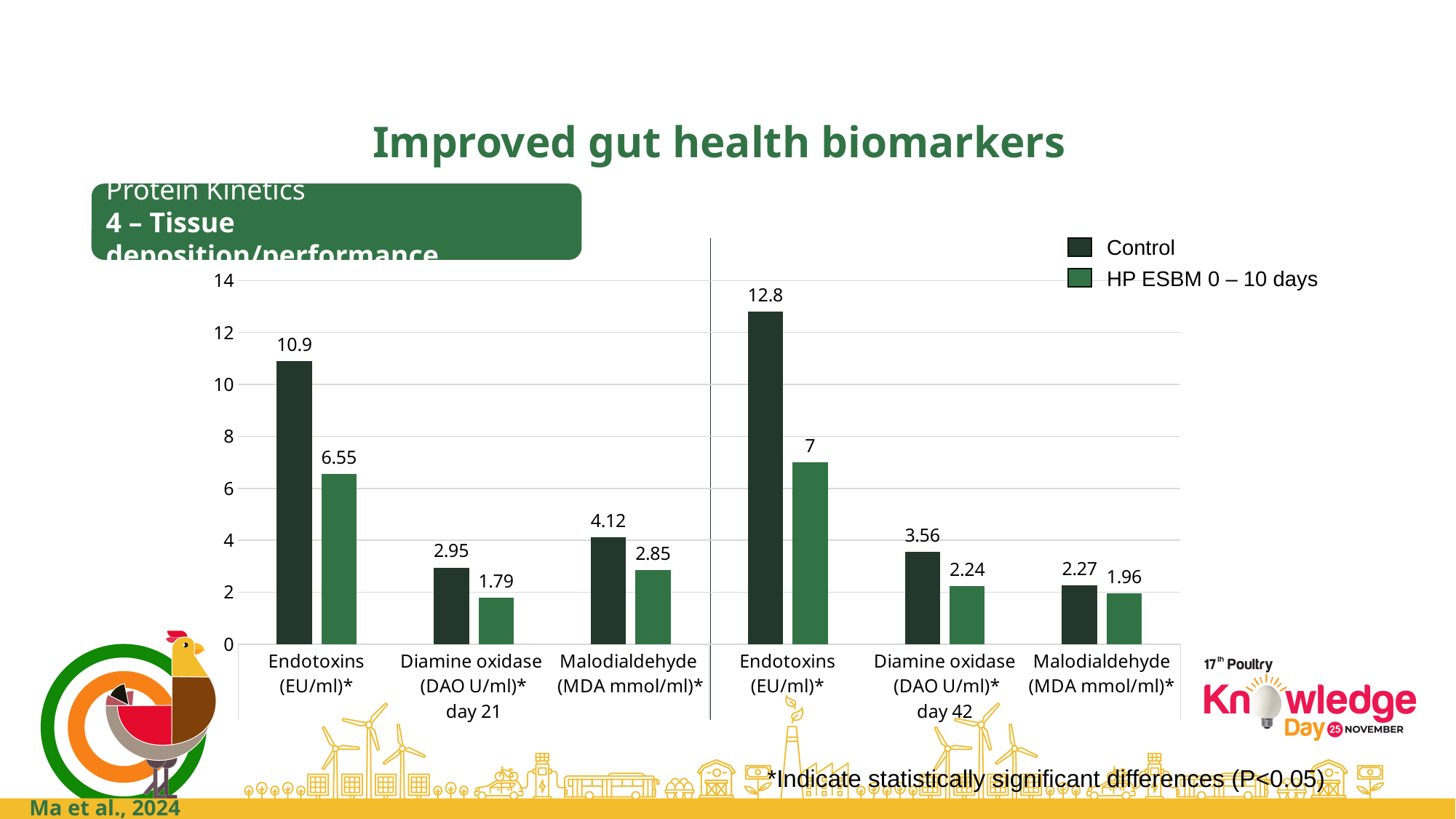
What is the difference between the Control and HP ESBM 0 – 10 days values for Endotoxins (EU/ml) at day 42? 5.8 What is the HP ESBM 0 – 10 days value for Endotoxins (EU/ml) at day 42? 7 What is the Control value for Endotoxins (EU/ml) at day 21? 10.9 Which category has the highest Control value across both days? Endotoxins (EU/ml) day 42 How many series does the legend list? 2 What colour represents the Control series in the legend? Dark green Which is larger: the Control value for Diamine oxidase at day 21 or the Control value for Diamine oxidase at day 42? Day 42 (3.56) What kind of chart is shown on the slide? Bar chart What is the difference between the Control and HP ESBM 0 – 10 days values for Malodialdehyde (MDA mmol/ml) at day 21? 1.27 Which category has the lowest HP ESBM 0 – 10 days value across both days? Diamine oxidase (DAO U/ml) day 21 What is the HP ESBM 0 – 10 days value for Diamine oxidase (DAO U/ml) at day 21? 1.79 What is the Control value for Malodialdehyde (MDA mmol/ml) at day 42? 2.27